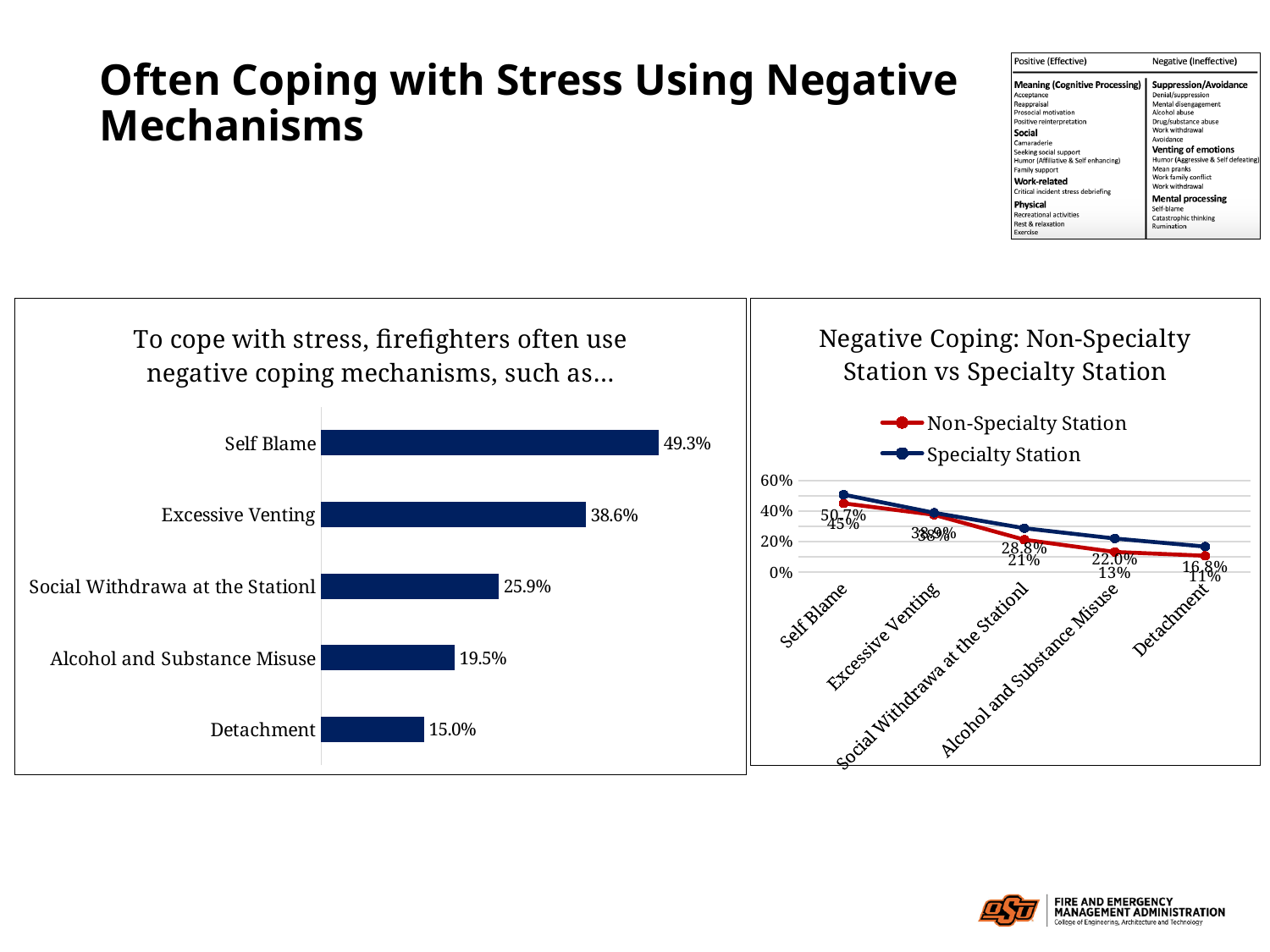
In the 'Negative Coping: Non-Specialty Station vs Specialty Station' chart, how many series does the legend list? 2 In the left bar chart, what is the value for Self Blame? 49.3% What kind of chart is the left chart? Bar chart In the 'Negative Coping: Non-Specialty Station vs Specialty Station' chart, which series is higher for Alcohol and Substance Misuse? Specialty Station In the 'Negative Coping: Non-Specialty Station vs Specialty Station' chart, what is the Specialty Station value for Self Blame? 50.7% In the 'Negative Coping: Non-Specialty Station vs Specialty Station' chart, what is the Non-Specialty Station value for Detachment? 11% In the left bar chart, how many coping mechanisms are shown? 5 In the left bar chart, what is the difference between Excessive Venting and Alcohol and Substance Misuse? 19.1% In the left bar chart, what is the value for Detachment? 15.0% In the left bar chart, which coping mechanism has the highest value? Self Blame In the 'Negative Coping: Non-Specialty Station vs Specialty Station' chart, do the values rise or fall from Self Blame to Detachment? Fall In the left bar chart, which coping mechanism has the lowest value? Detachment